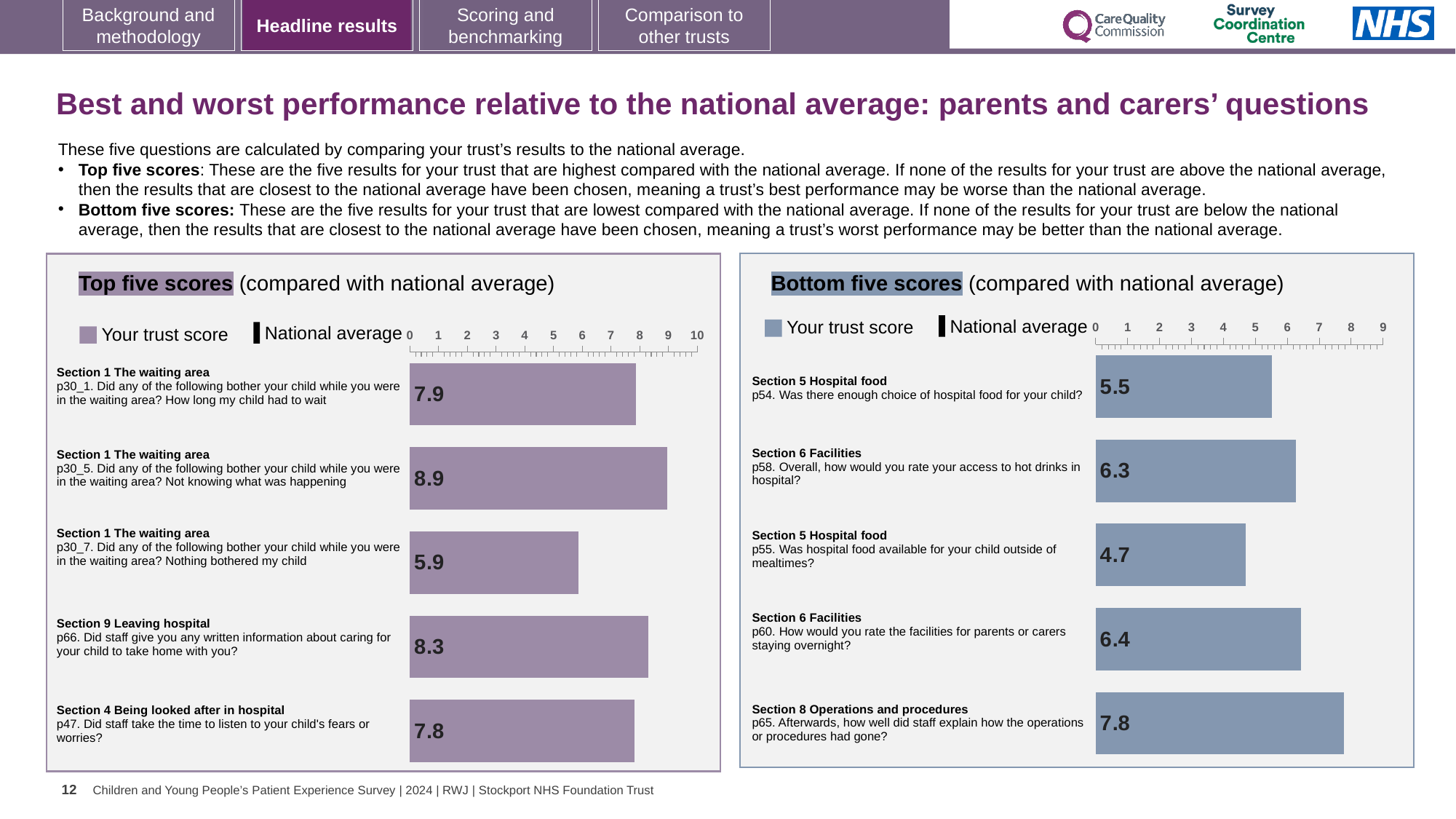
In the Bottom five scores chart, what is the trust score for p65 (how well staff explained how the operations or procedures had gone)? 7.8 In the Top five scores chart, what is the trust score for p66 (written information about caring for your child to take home)? 8.3 In the Bottom five scores chart, what is the difference between the trust scores for p65 and p55? 3.1 In the Bottom five scores chart, what is the trust score for p55 (hospital food available outside of mealtimes)? 4.7 In the Top five scores chart, which question has the lowest trust score? p30_7. Did any of the following bother your child while you were in the waiting area? Nothing bothered my child In the Top five scores chart, which question has the highest trust score? p30_5. Did any of the following bother your child while you were in the waiting area? Not knowing what was happening What type of chart is used for the Top five scores? Bar chart In the Top five scores chart, which has the larger trust score: p30_1 (How long my child had to wait) or p47 (staff took time to listen to your child's fears or worries)? p30_1 (7.9) In the Top five scores chart, what is the trust score for p30_5 (Not knowing what was happening in the waiting area)? 8.9 How many entries does the legend of the Bottom five scores chart list? 2 In the Bottom five scores chart, which question has the lowest trust score? p55. Was hospital food available for your child outside of mealtimes? How many questions are shown in the Bottom five scores chart? 5